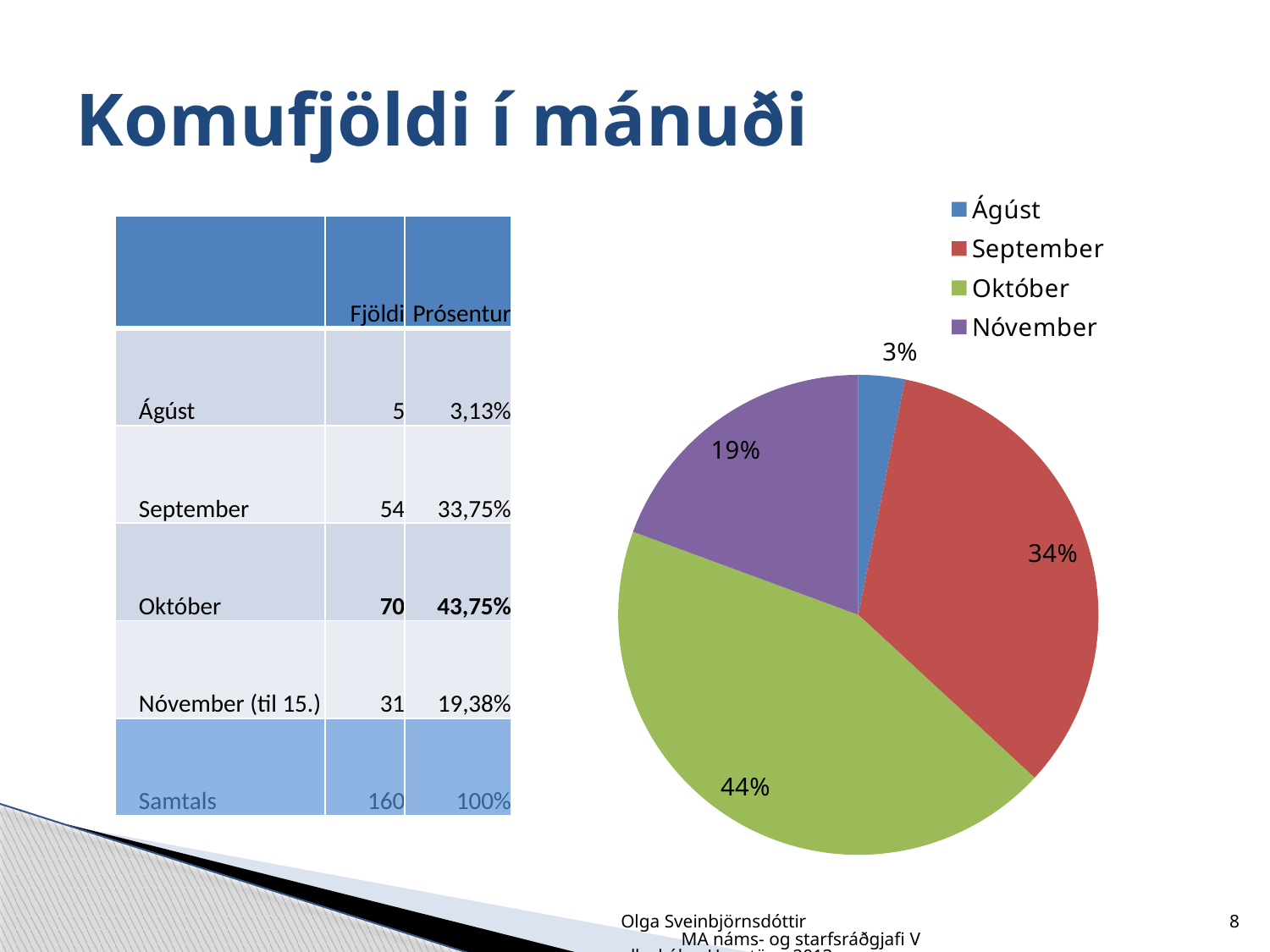
What kind of chart is shown on the slide? pie chart What colour is the Október slice in the pie chart? green How many entries does the pie chart's legend list? 4 What share of the pie chart does Nóvember have? 19% In the pie chart, which slice is larger, September or Nóvember? September How many slices does the pie chart have? 4 Which month has the smallest slice in the pie chart? Ágúst What share of the pie chart does Ágúst have? 3% What share of the pie chart does Október have? 44% In the pie chart, what is the difference in percentage points between the Október slice and the September slice? 10% Which month has the largest slice in the pie chart? Október